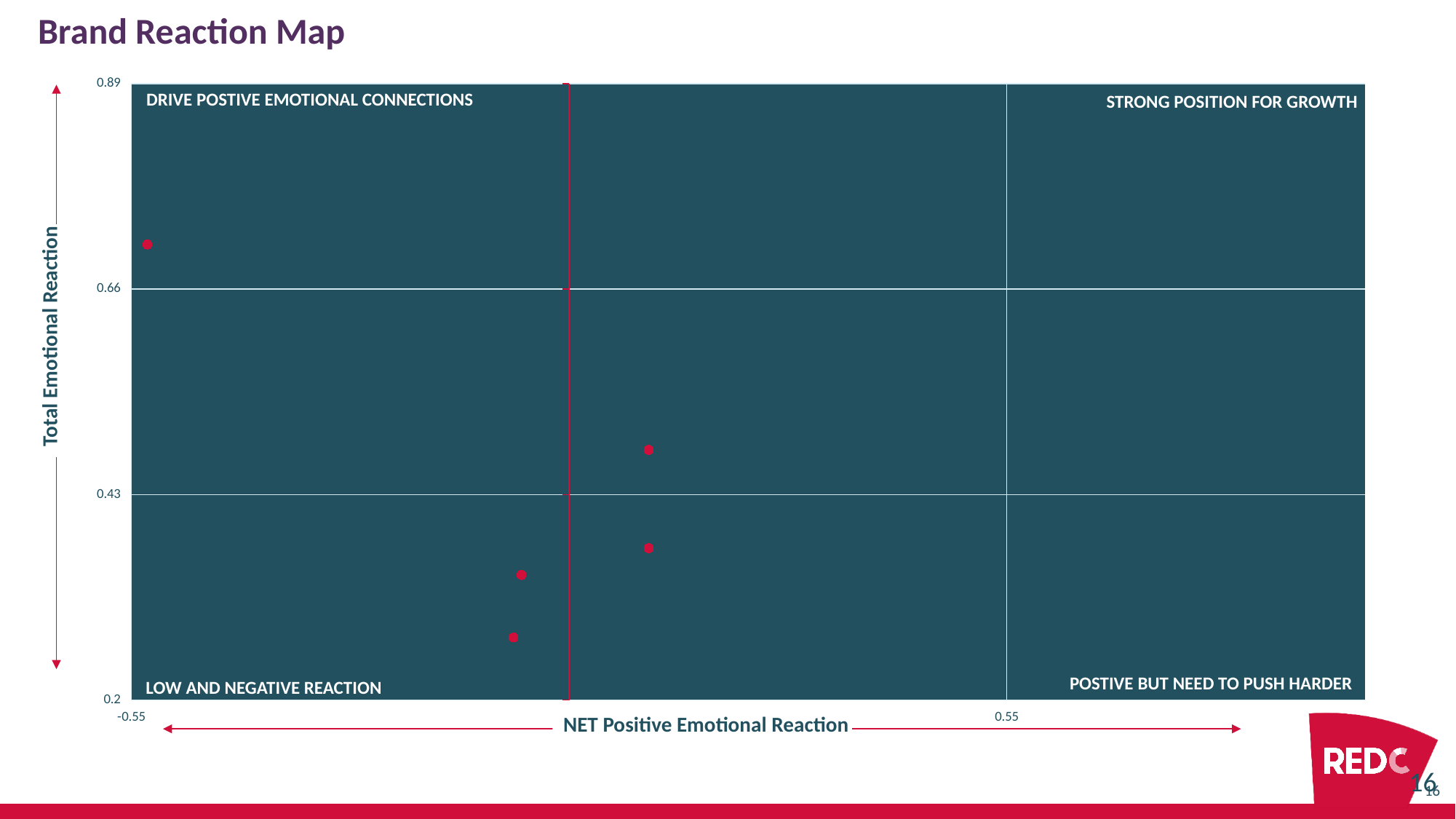
What is the label of the vertical axis? Total Emotional Reaction How many plotted points fall in the STRONG POSITION FOR GROWTH quadrant? 0 What is the maximum value shown on the vertical axis? 0.89 Is the Total Emotional Reaction of the lowest plotted point greater or less than 0.43? less What is the title of the chart on the slide? Brand Reaction Map Which quadrant contains the point with the highest Total Emotional Reaction? DRIVE POSTIVE EMOTIONAL CONNECTIONS Is the Total Emotional Reaction of the highest plotted point greater or less than 0.66? greater What kind of chart is shown on the slide? Scatter chart How many plotted points lie to the right of the red vertical line? 2 How many plotted points have a Total Emotional Reaction above 0.43? 2 Which quadrant contains the point with the lowest Total Emotional Reaction? LOW AND NEGATIVE REACTION